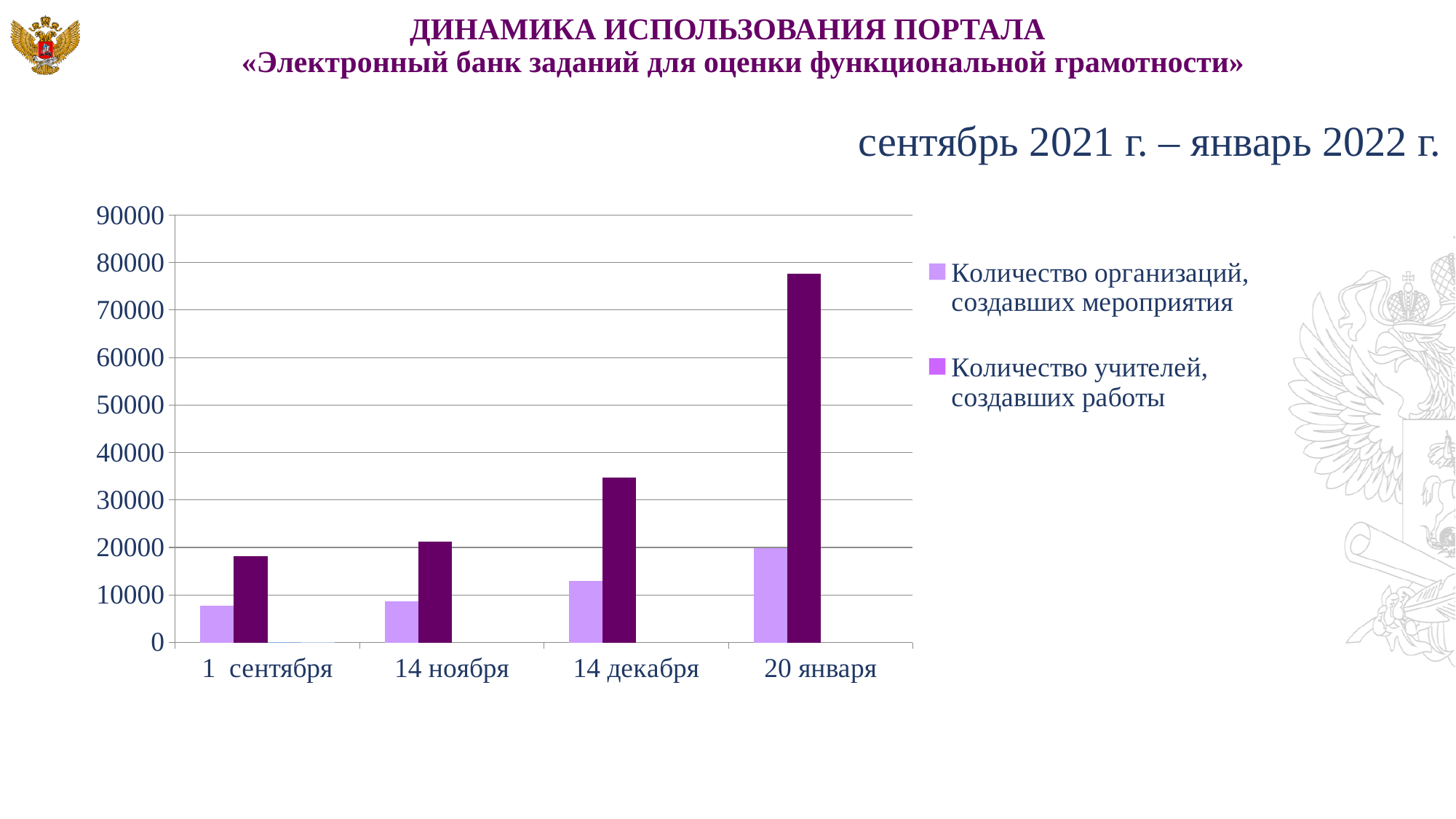
On which date is the value for «Количество учителей, создавших работы» highest? 20 января Is the value for «Количество учителей, создавших работы» on 14 декабря greater or less than 30000? greater On 20 января, which series has the larger value: «Количество организаций, создавших мероприятия» or «Количество учителей, создавших работы»? Количество учителей, создавших работы How many dates are shown on the x axis of the chart? 4 What period is stated above the chart? сентябрь 2021 г. – январь 2022 г. Is the value for «Количество организаций, создавших мероприятия» on 1 сентября greater or less than 10000? less Is the value for «Количество учителей, создавших работы» on 20 января greater or less than 70000? greater How many series does the chart legend list? 2 Do the values for «Количество учителей, создавших работы» rise or fall from 1 сентября to 20 января? Rise What kind of chart is shown on the slide? Bar chart On which date is the value for «Количество организаций, создавших мероприятия» highest? 20 января